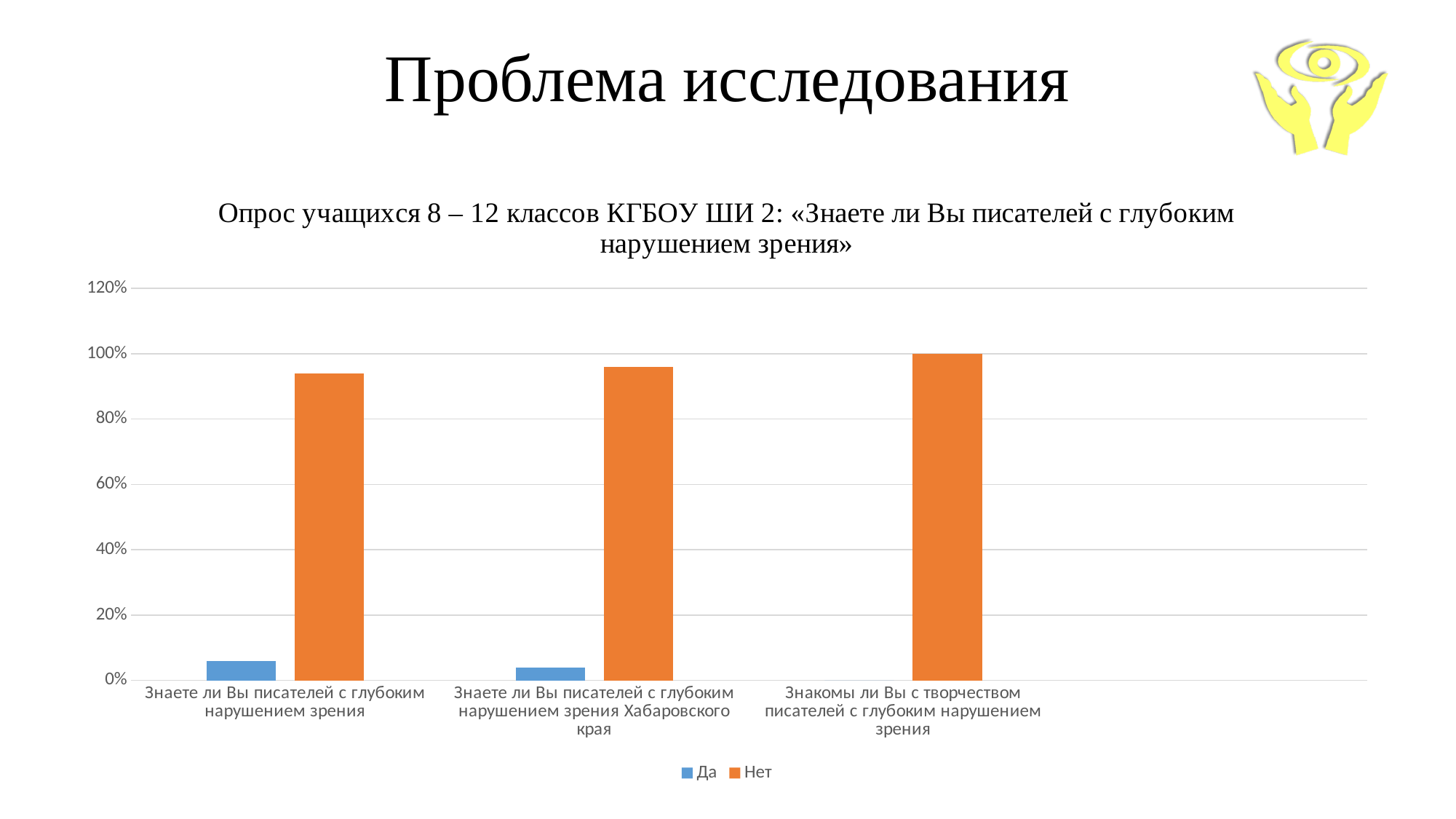
What kind of chart is shown on the slide? bar chart What are the two series named in the legend? Да and Нет What is the value of «Нет» for the category «Знакомы ли Вы с творчеством писателей с глубоким нарушением зрения»? 100% Is the value of «Нет» for «Знаете ли Вы писателей с глубоким нарушением зрения Хабаровского края» greater or less than 80%? greater Is the value of «Да» for «Знаете ли Вы писателей с глубоким нарушением зрения Хабаровского края» greater or less than 20%? less Which series is shown in orange? Нет How many categories are shown on the x axis? 3 How many series does the legend list? 2 Is the value of «Нет» for «Знаете ли Вы писателей с глубоким нарушением зрения» greater or less than 80%? greater For the category «Знаете ли Вы писателей с глубоким нарушением зрения», which is larger: «Да» or «Нет»? Нет Which category has the highest value for «Нет»? Знакомы ли Вы с творчеством писателей с глубоким нарушением зрения